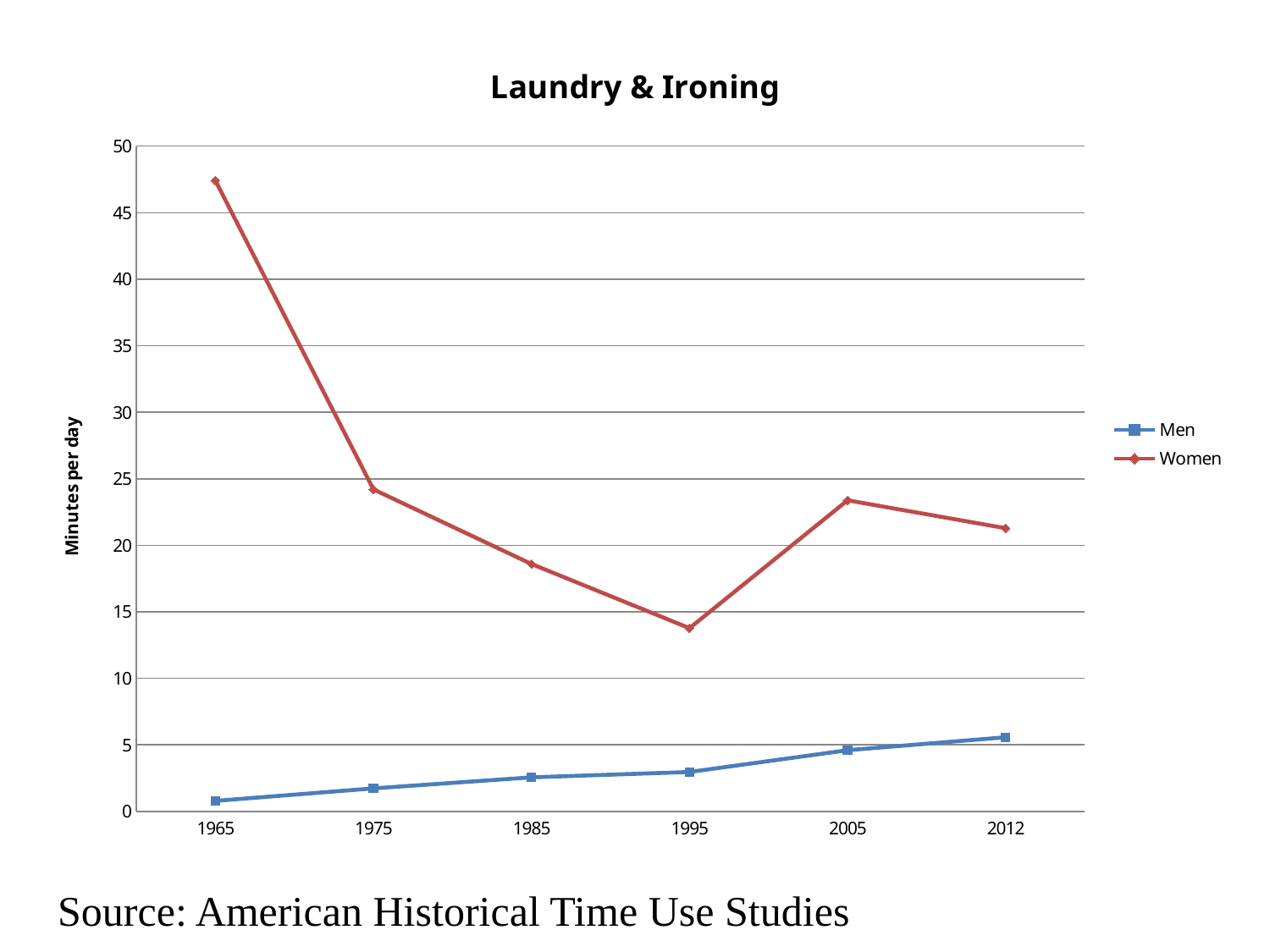
Is the value for Women in 1965 greater or less than 45? greater In which year is the value for Women lowest? 1995 How many years are shown on the x axis? 6 Which series has the higher value in 1965, Men or Women? Women In which year is the value for Women highest? 1965 In which year is the value for Men highest? 2012 Is the value for Women in 1995 greater or less than 15? less Is the value for Men in 2012 greater or less than 5? greater What is the title of the chart? Laundry & Ironing Does the value for Men rise or fall from 1965 to 2012? rise What kind of chart is shown on the slide? line chart How many series does the legend list? 2